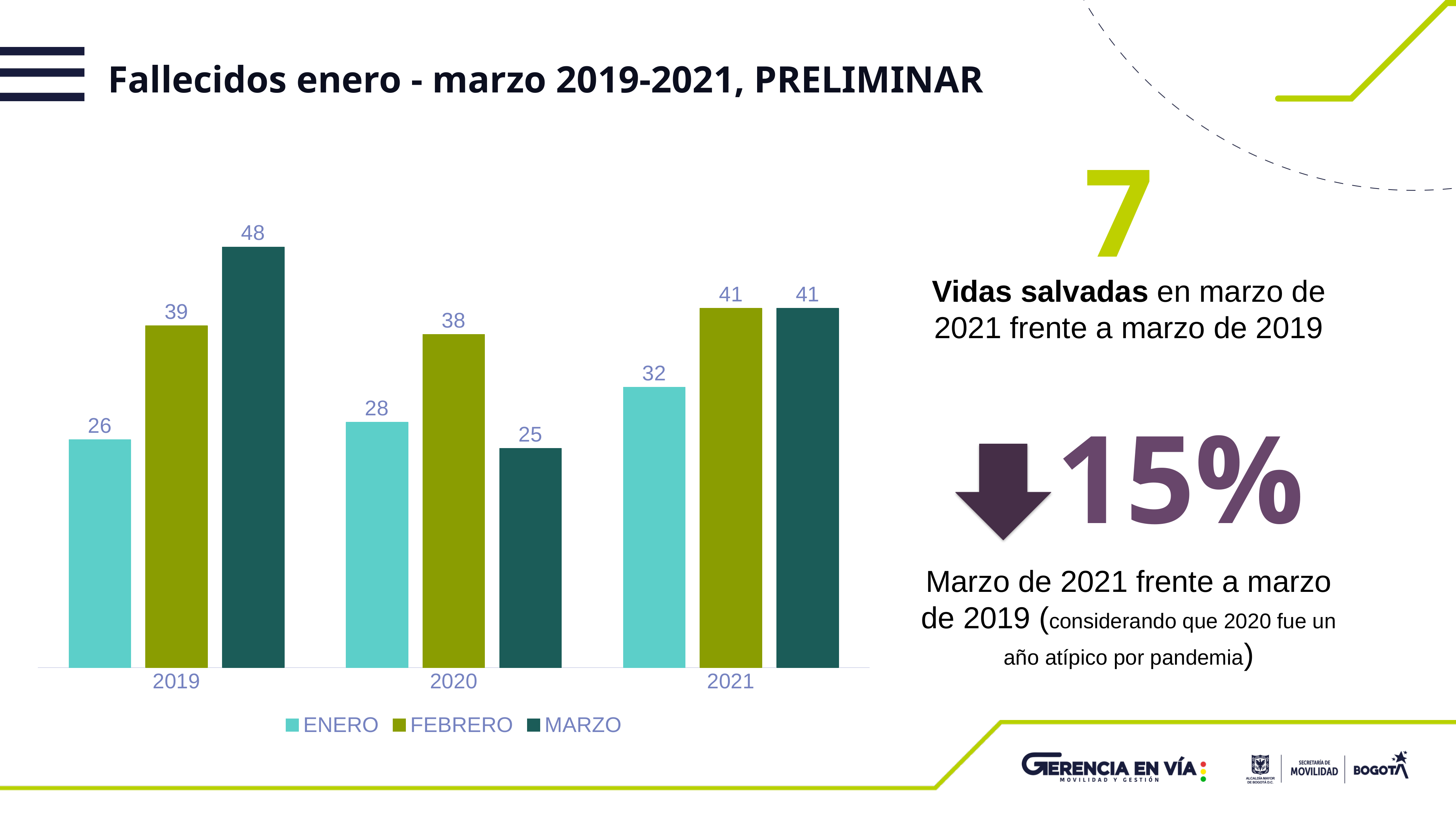
What is the value for ENERO in 2020? 28 What is the title of the slide? Fallecidos enero - marzo 2019-2021, PRELIMINAR What is the value for MARZO in 2019? 48 Do the ENERO values rise or fall from 2019 to 2021? Rise How many series does the legend list? 3 Which year has the lowest value for ENERO? 2019 What kind of chart is shown on the slide? Bar chart Which is larger, the MARZO value for 2020 or the FEBRERO value for 2020? FEBRERO What is the difference between the MARZO values for 2019 and 2021? 7 Which year has the highest value for MARZO? 2019 How many years are shown on the x axis? 3 What is the value for FEBRERO in 2021? 41